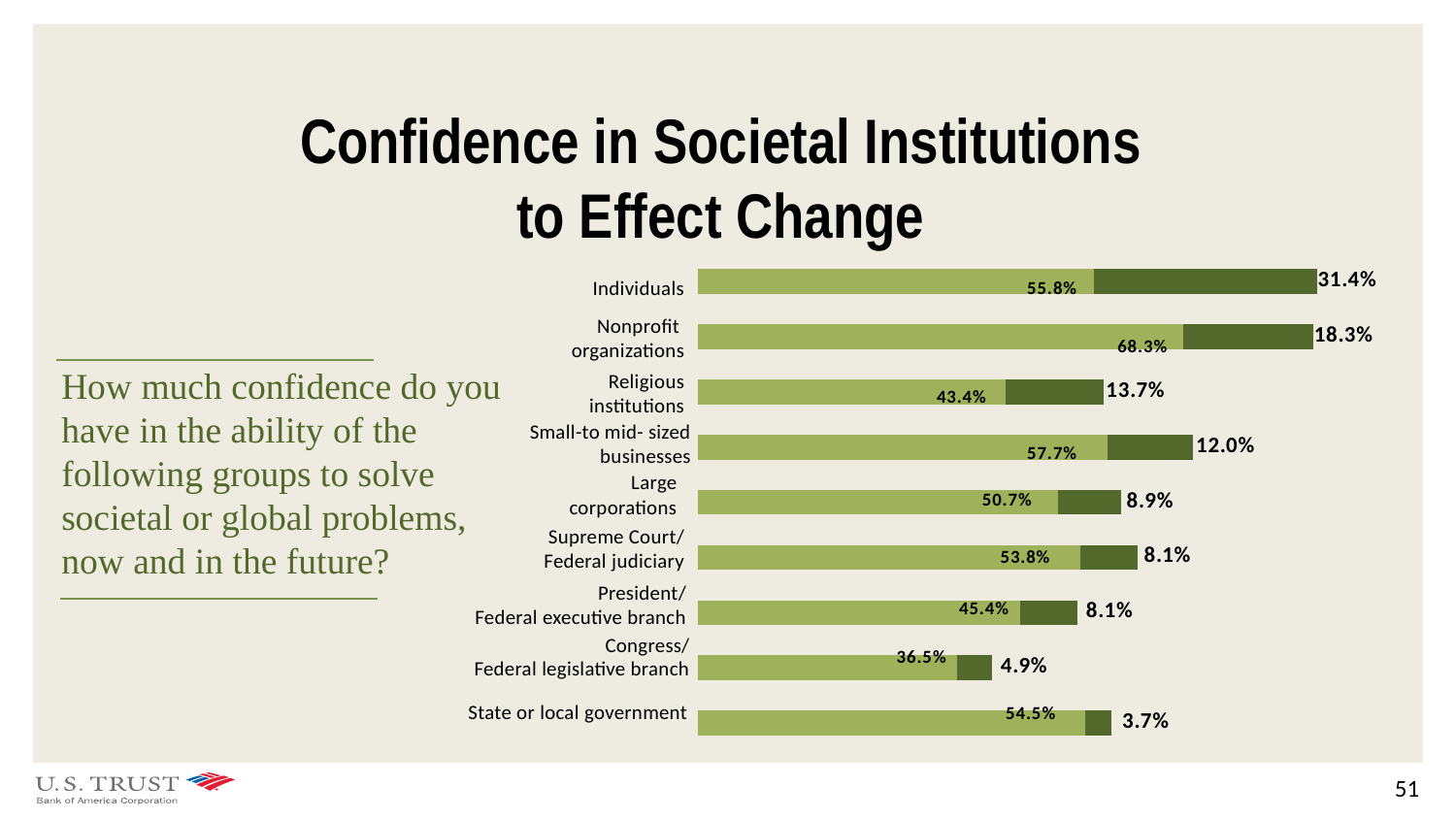
Which category has the lowest light green segment value? Congress/Federal legislative branch What is the light green segment value for Congress/Federal legislative branch? 36.5% What is the dark green segment value for Individuals? 31.4% Which category has the highest light green segment value? Nonprofit organizations What is the total of the two segments for Individuals? 87.2% What is the dark green segment value for State or local government? 3.7% What is the light green segment value for Nonprofit organizations? 68.3% Which category has the highest dark green segment value? Individuals What type of chart is shown on the slide? Stacked bar chart What is the difference between the dark green values for Individuals and Nonprofit organizations? 13.1% Which is larger, the light green value for Large corporations or for Supreme Court/Federal judiciary? Supreme Court/Federal judiciary How many categories are shown in the chart? 9